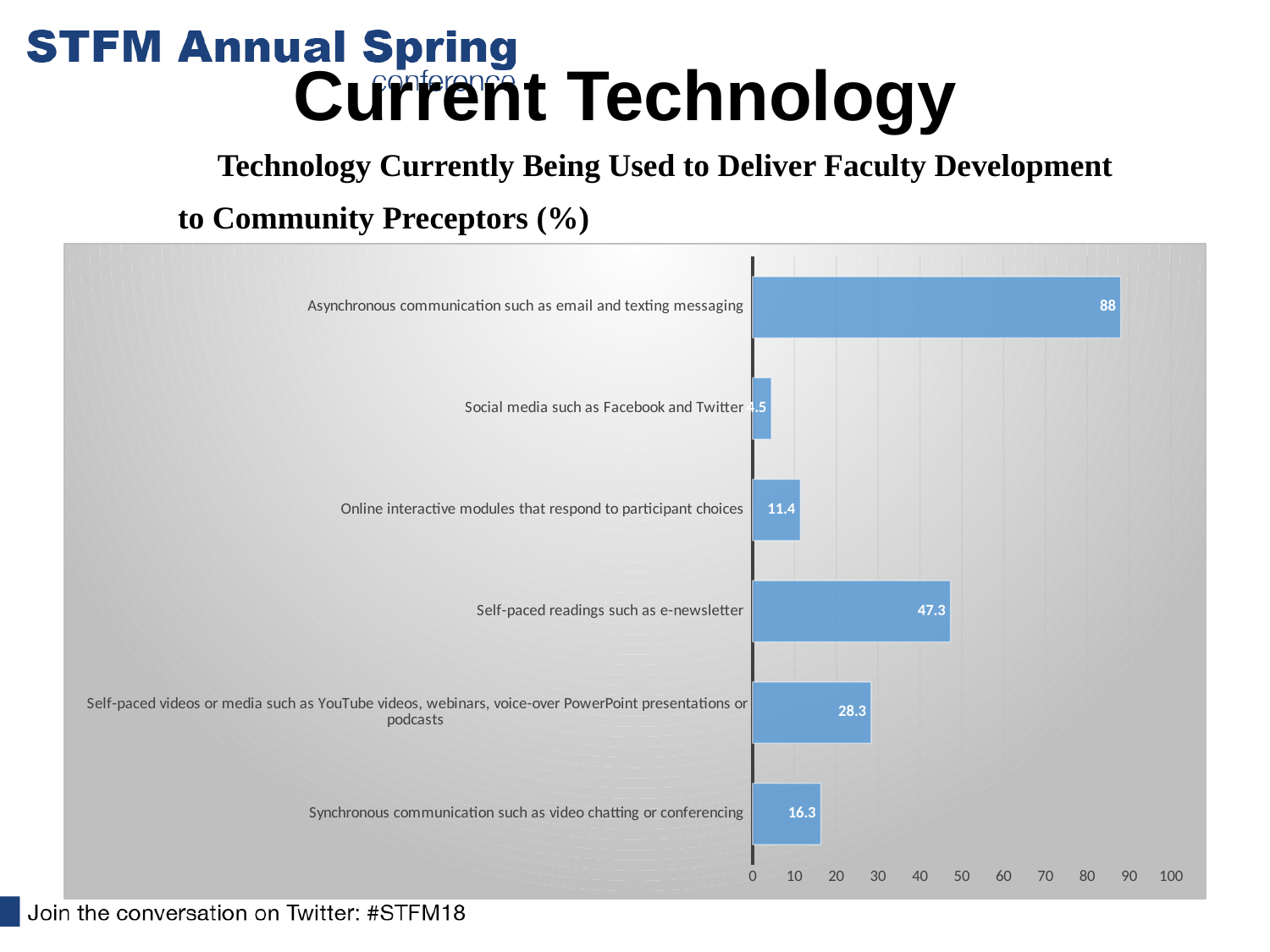
What is the title of the chart? Technology Currently Being Used to Deliver Faculty Development to Community Preceptors (%) How many categories are shown in the chart? 6 What is the value for Asynchronous communication such as email and texting messaging? 88 Which category has the lowest value? Social media such as Facebook and Twitter What is the value for Synchronous communication such as video chatting or conferencing? 16.3 Which is larger: the value for Synchronous communication such as video chatting or conferencing or the value for Online interactive modules that respond to participant choices? Synchronous communication such as video chatting or conferencing Is the value for Self-paced videos or media such as YouTube videos, webinars, voice-over PowerPoint presentations or podcasts greater or less than 20? greater What is the value for Online interactive modules that respond to participant choices? 11.4 What kind of chart is shown on the slide? bar chart What is the value for Self-paced readings such as e-newsletter? 47.3 Which category has the highest value? Asynchronous communication such as email and texting messaging What is the difference between the values for Self-paced readings such as e-newsletter and Self-paced videos or media such as YouTube videos, webinars, voice-over PowerPoint presentations or podcasts? 19